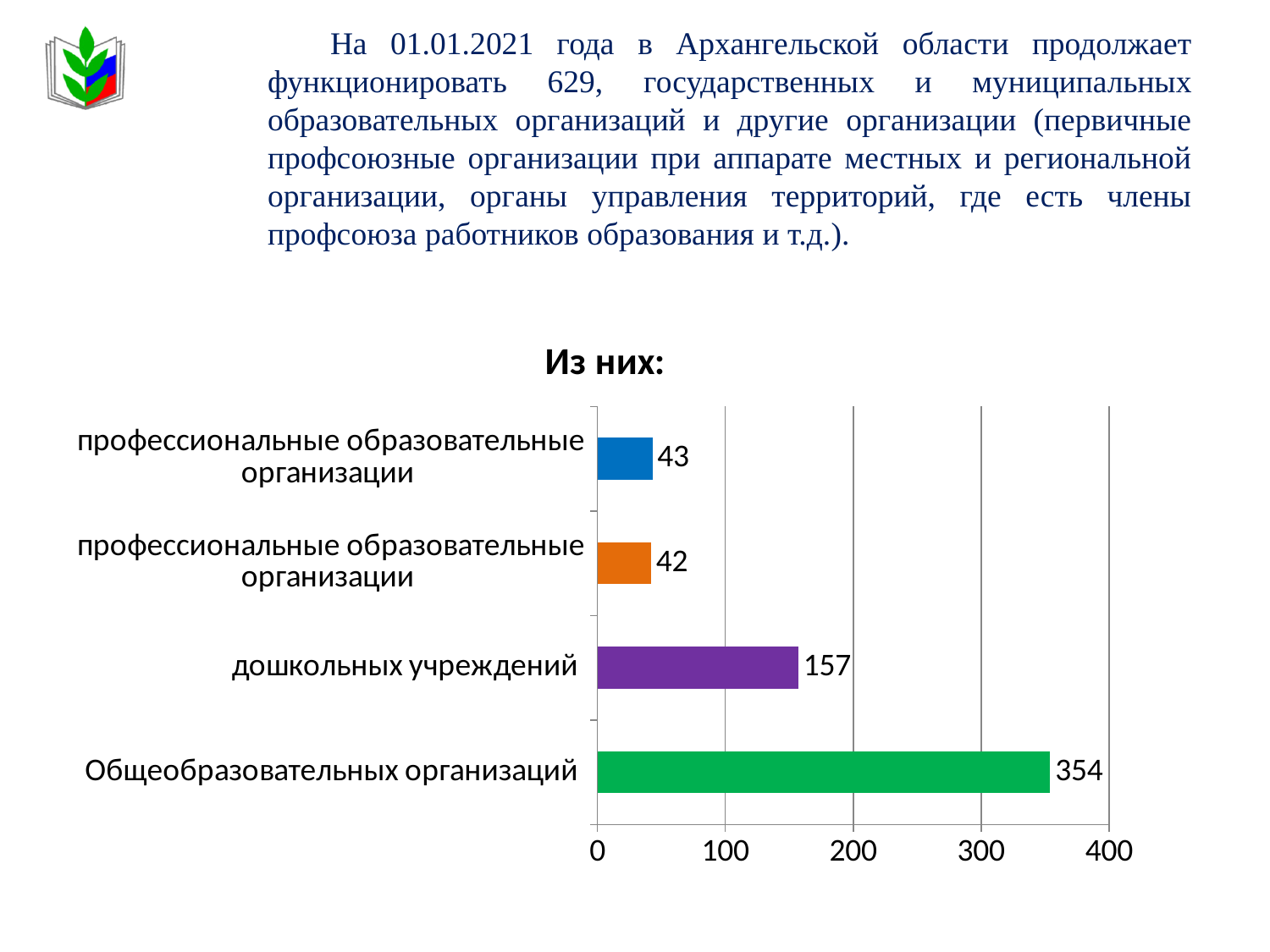
What is the value of the topmost bar (blue) in the chart? 43 What is the value for дошкольных учреждений? 157 What is the value of the second bar from the top (orange) in the chart? 42 What is the chart's title? Из них: What type of chart is shown on the slide? bar chart How many bars does the chart show? 4 What is the difference between the values for Общеобразовательных организаций and дошкольных учреждений? 197 What colour is the bar for Общеобразовательных организаций? green Is the value for Общеобразовательных организаций greater or less than 300? greater Which category has the highest value? Общеобразовательных организаций Which is larger: the value for дошкольных учреждений or the value of the topmost bar? дошкольных учреждений What is the value for Общеобразовательных организаций? 354